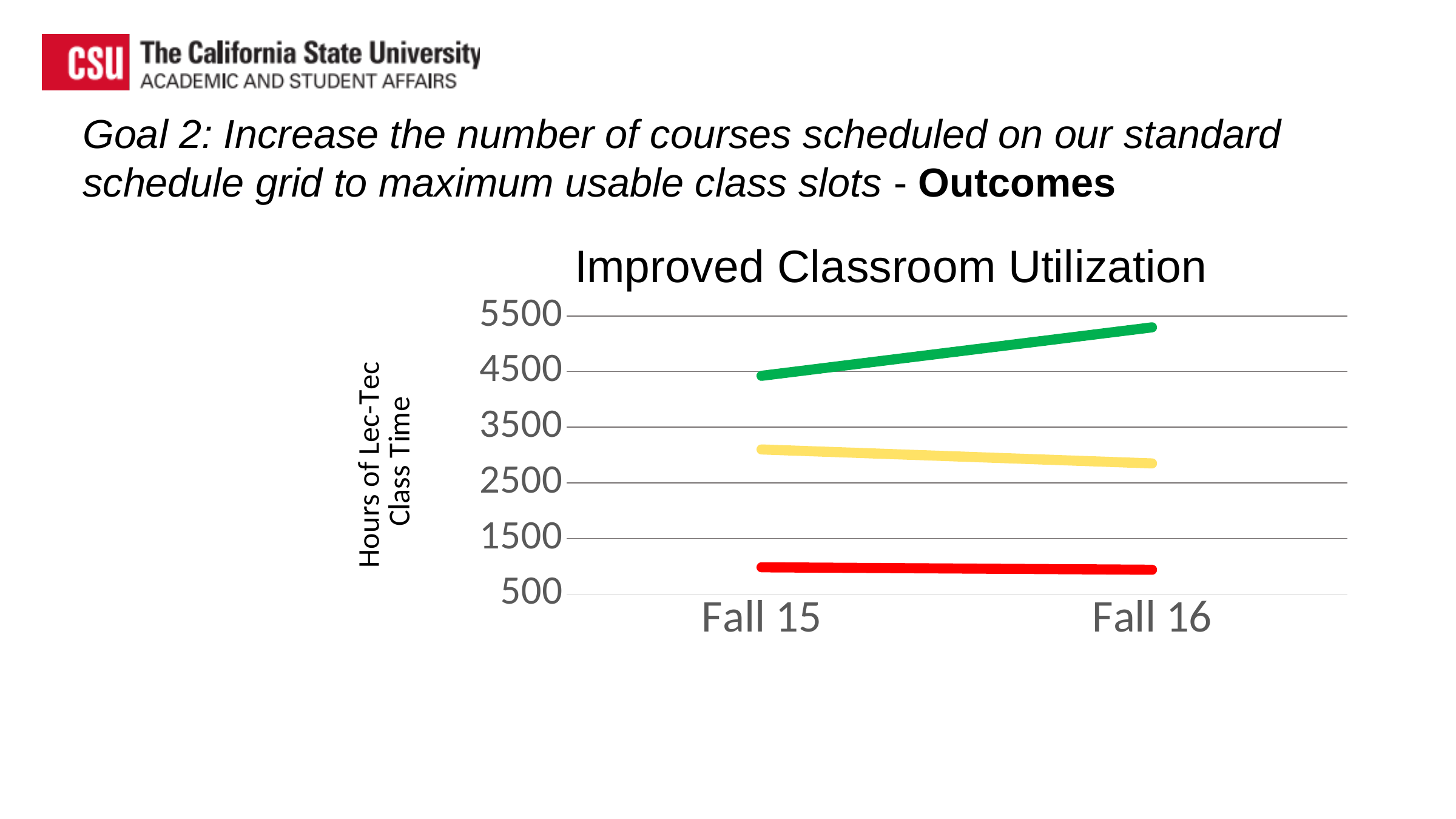
Which coloured line has the highest values in the chart? green Does the green line rise or fall from Fall 15 to Fall 16? rise Is the value of the red line at Fall 15 greater or less than 1500? less How many categories are shown on the x axis of the chart? 2 What kind of chart is shown on the slide? line chart Is the value of the green line at Fall 16 greater or less than 4500? greater What is the title of the chart? Improved Classroom Utilization Does the yellow line rise or fall from Fall 15 to Fall 16? fall What is the label on the vertical axis of the chart? Hours of Lec-Tec Class Time Which coloured line has the lowest values in the chart? red Is the value of the yellow line at Fall 15 greater or less than 2500? greater At Fall 16, which is larger: the value of the green line or the value of the yellow line? green line